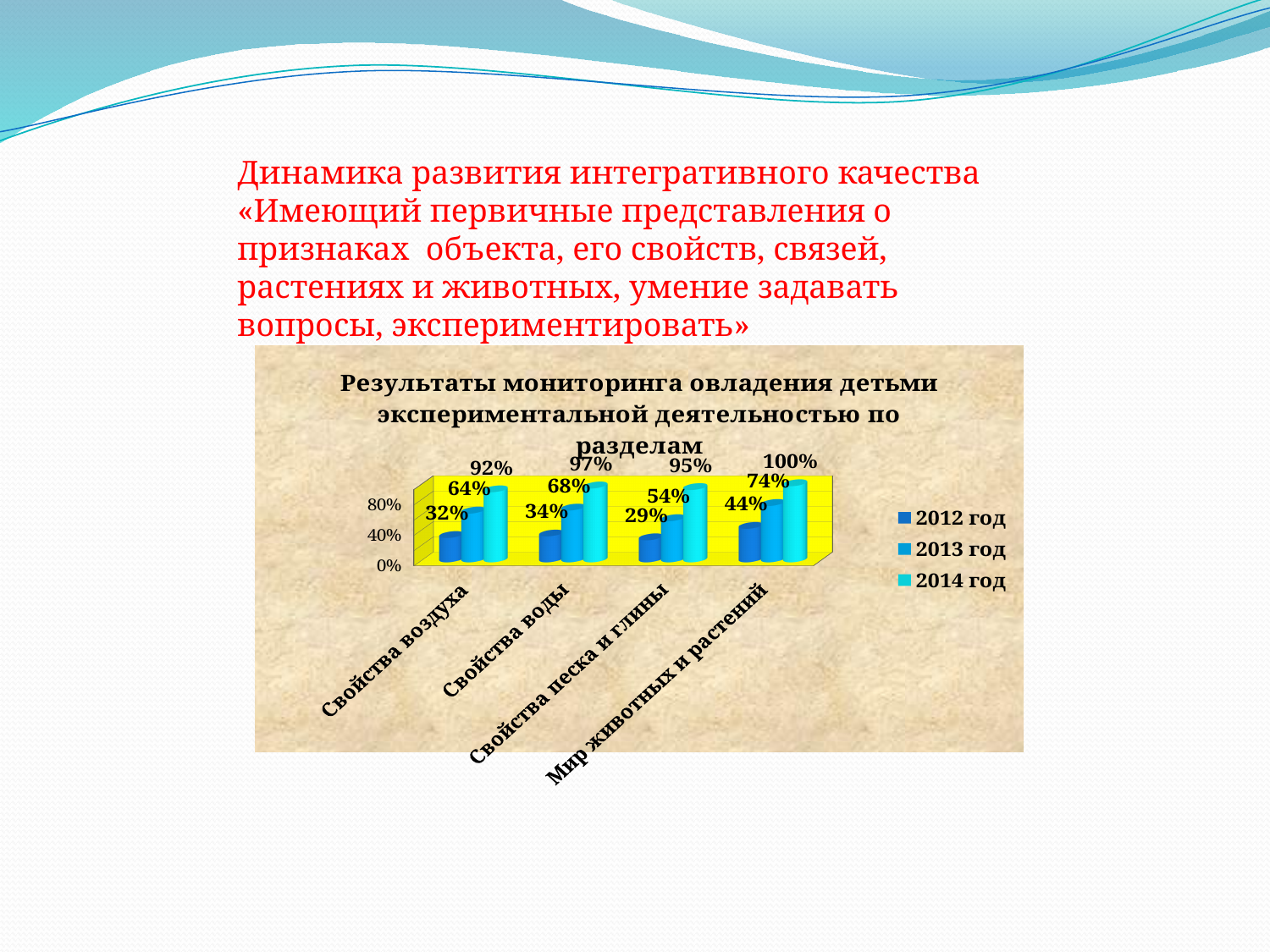
Which is larger: the 2013 год value for Свойства воды or the 2013 год value for Свойства воздуха? Свойства воды What is the value for 2012 год in the category Свойства воздуха? 32% Which category has the lowest value for 2012 год? Свойства песка и глины What is the value for 2014 год in the category Свойства воды? 97% What is the difference between the 2014 год and 2012 год values for Мир животных и растений? 56% What type of chart is shown on the slide? Bar chart What is the value for 2013 год in the category Свойства песка и глины? 54% Which category has the highest value for 2014 год? Мир животных и растений How many series does the legend list? 3 Do the values for each category rise or fall from 2012 год to 2014 год? Rise How many categories are shown on the x axis? 4 What is the title of the chart? Результаты мониторинга овладения детьми экспериментальной деятельностью по разделам